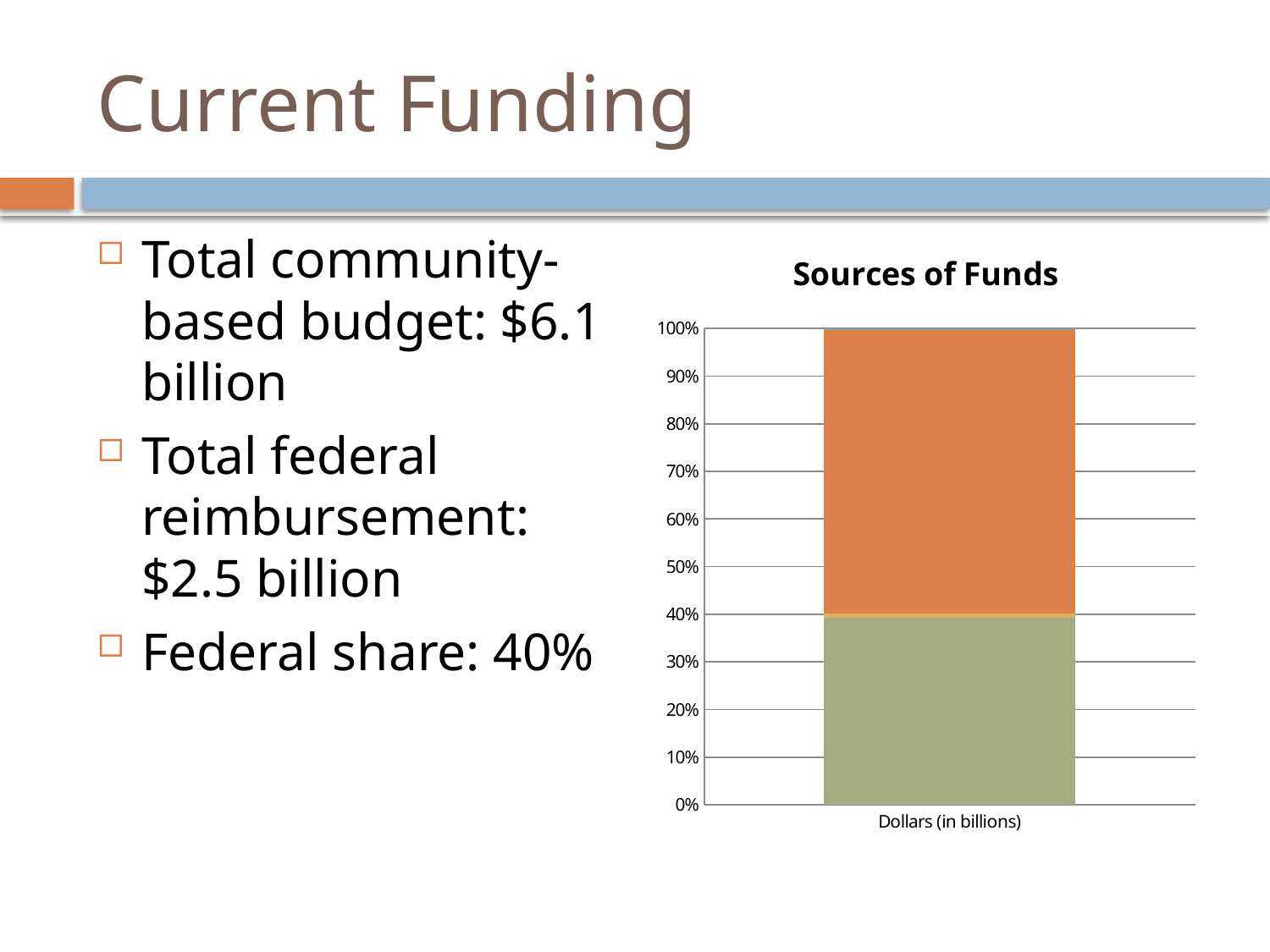
What kind of chart is shown on the slide? bar chart How many bars are plotted in the chart? 1 What is the title of the chart? Sources of Funds What is the highest value shown on the y axis of the chart? 100% Is the green (bottom) segment of the bar greater or less than 50%? less Is the orange (top) segment of the bar greater or less than 50%? greater Is the green (bottom) segment of the bar greater or less than 30%? greater What is the label on the x axis of the chart? Dollars (in billions) Which segment of the bar is larger, the orange one or the green one? orange What is the total height of the stacked bar in the chart? 100%